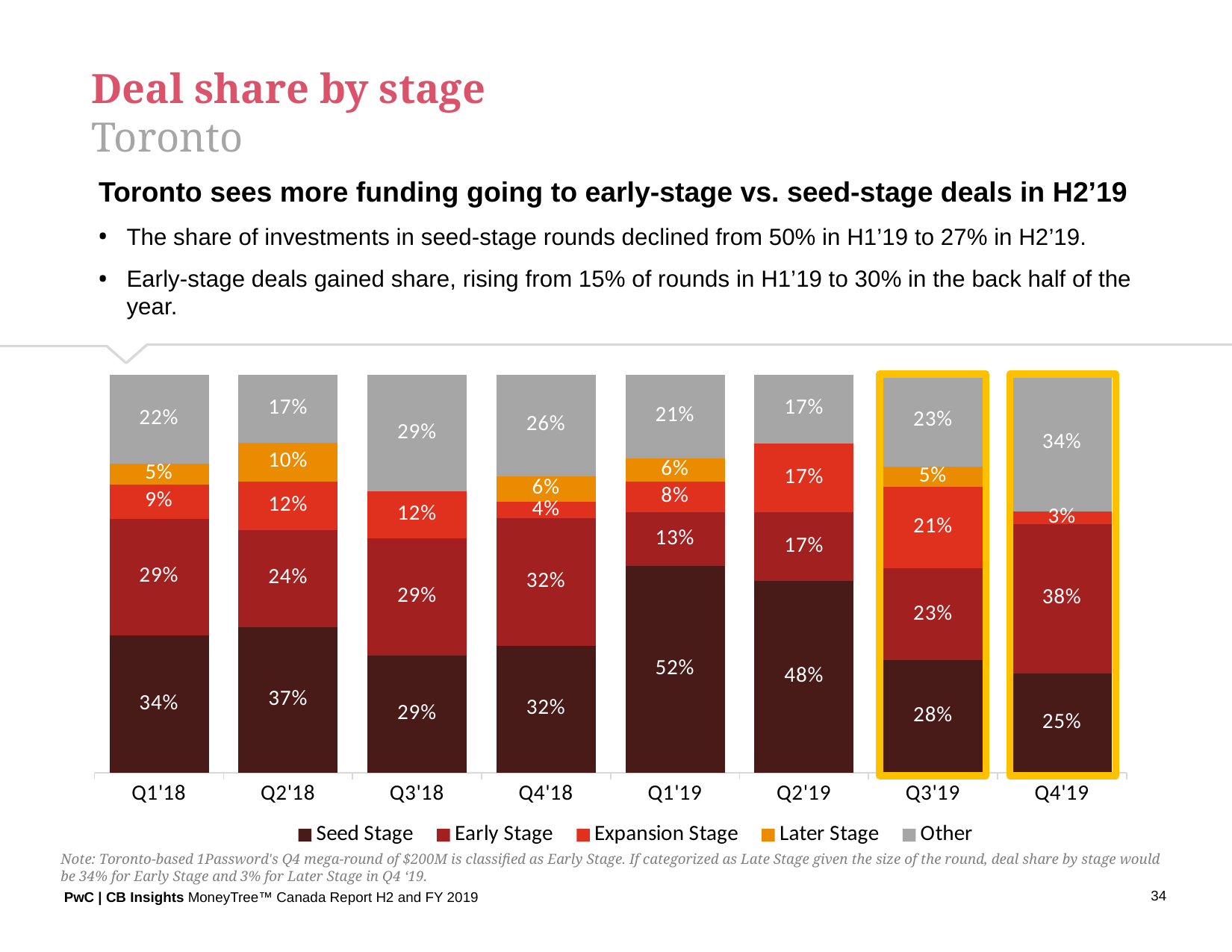
Which two quarters are highlighted with a yellow outline? Q3'19 and Q4'19 What is the Early Stage share in Q4'19? 38% What is the difference in Seed Stage share between Q1'19 and Q2'19? 4 percentage points How many quarters are shown on the x axis? 8 What kind of chart is shown on the slide? Stacked bar chart What is the Expansion Stage share in Q3'19? 21% What is the Seed Stage share in Q1'19? 52% How many series does the legend list? 5 Which is larger in Q4'19, the Early Stage share or the Seed Stage share? Early Stage In which quarter is the Seed Stage share highest? Q1'19 In which quarter is the Seed Stage share lowest? Q4'19 What is the Other share in Q3'18? 29%